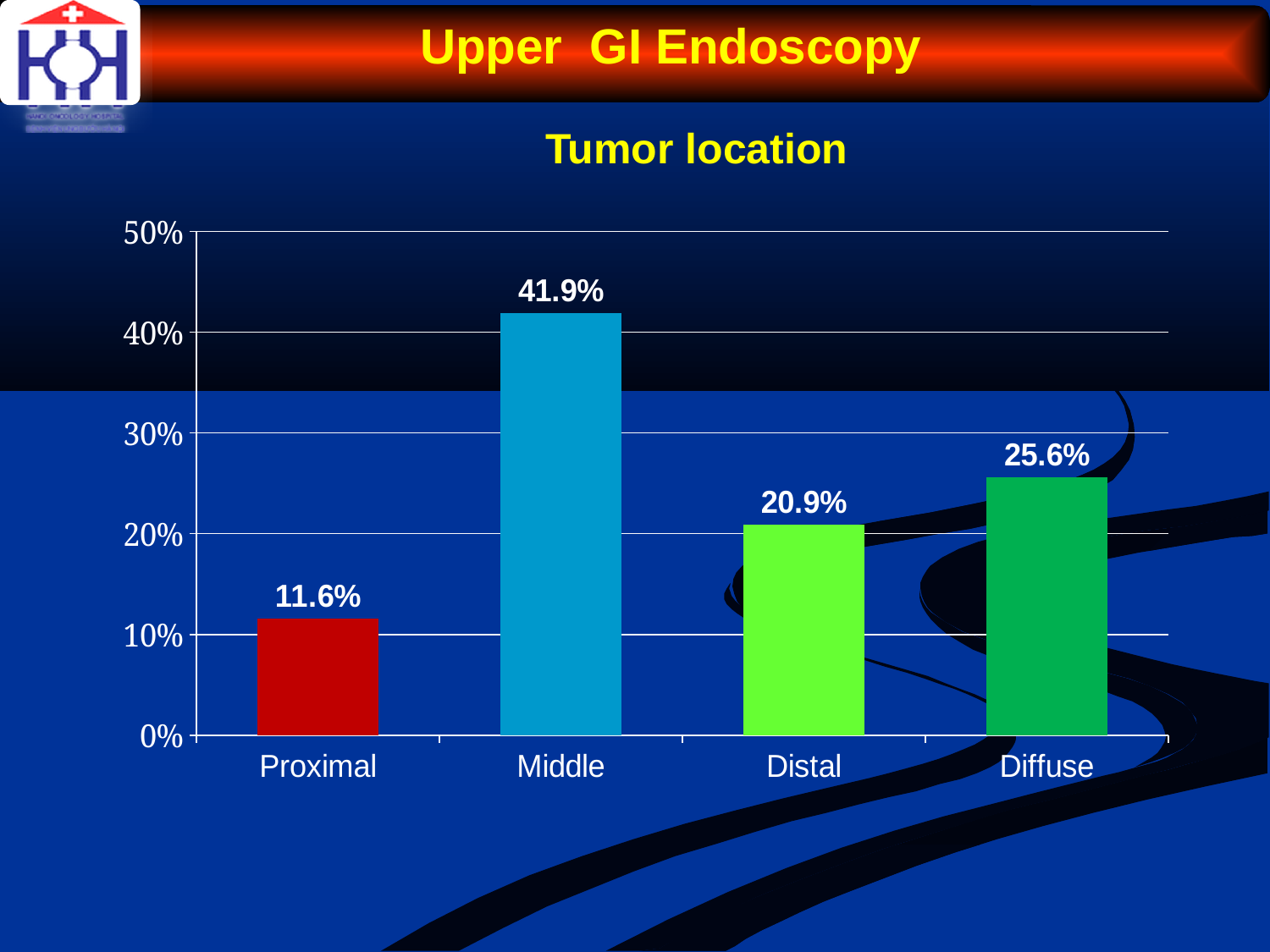
What is the value for Diffuse? 25.6% What is the value for Middle? 41.9% What kind of chart is shown on the slide? bar chart Which tumor location has the lowest value? Proximal What is the difference between the values for Diffuse and Distal? 4.7% What is the value for Distal? 20.9% How many tumor location categories are shown on the chart? 4 What is the difference between the values for Middle and Diffuse? 16.3% What is the value for Proximal? 11.6% Which is larger, the value for Distal or the value for Diffuse? Diffuse Is the value for Middle greater or less than 40%? greater Which tumor location has the highest value? Middle